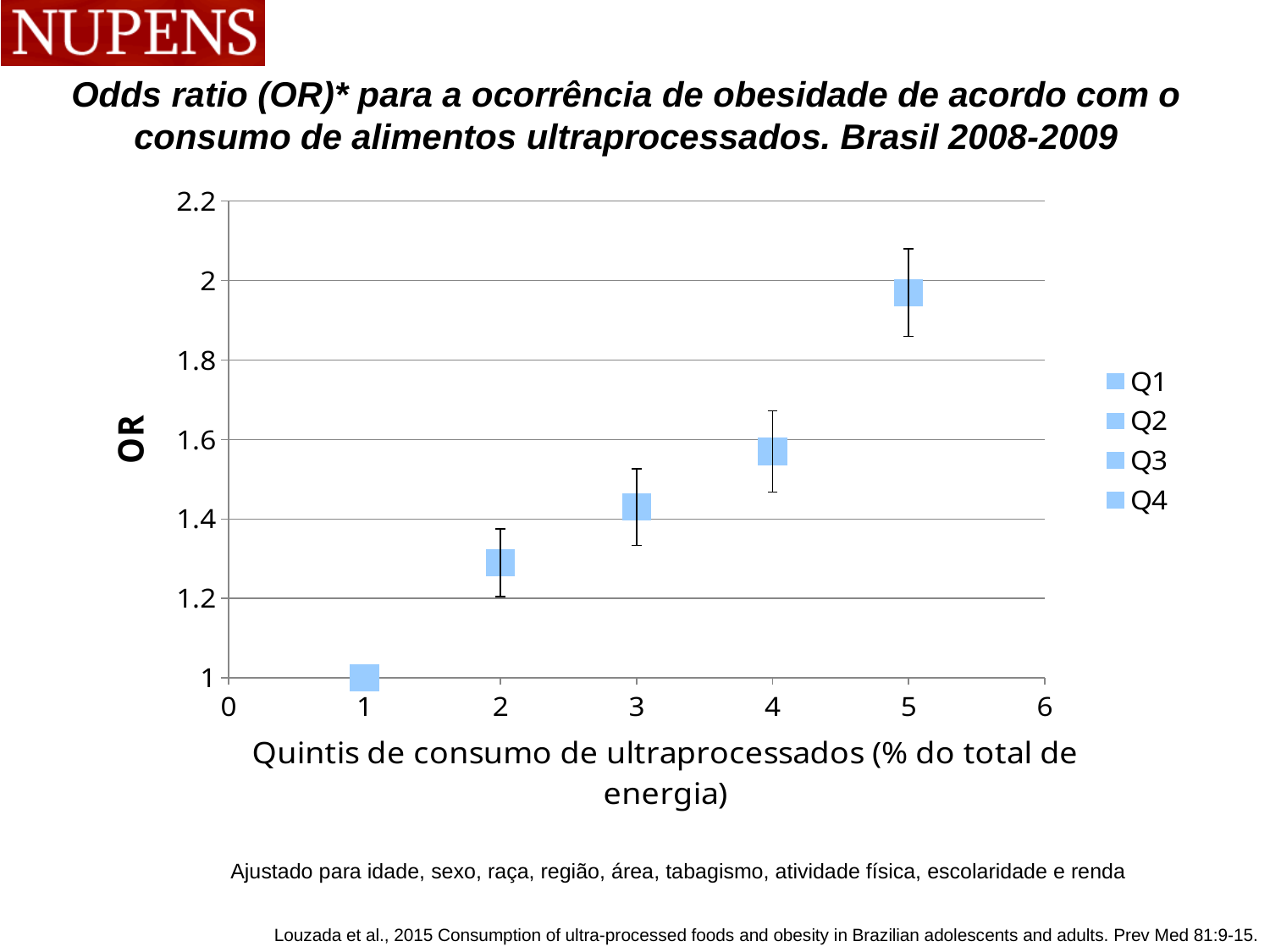
Is the OR value for quintile 2 greater or less than 1.4? less Which quintile has the highest OR? 5 Is the OR value for quintile 5 greater or less than 1.8? greater What is the OR value for quintile 1? 1 What is the title of the vertical axis? OR How many data points are plotted on the chart? 5 What kind of chart is shown on the slide? scatter chart Which quintile has the lowest OR? 1 Is the OR value for quintile 4 greater or less than 1.4? greater Which has a larger OR, quintile 3 or quintile 5? quintile 5 How many series does the legend list? 4 Do the OR values rise or fall as the quintile of ultra-processed food consumption increases? rise